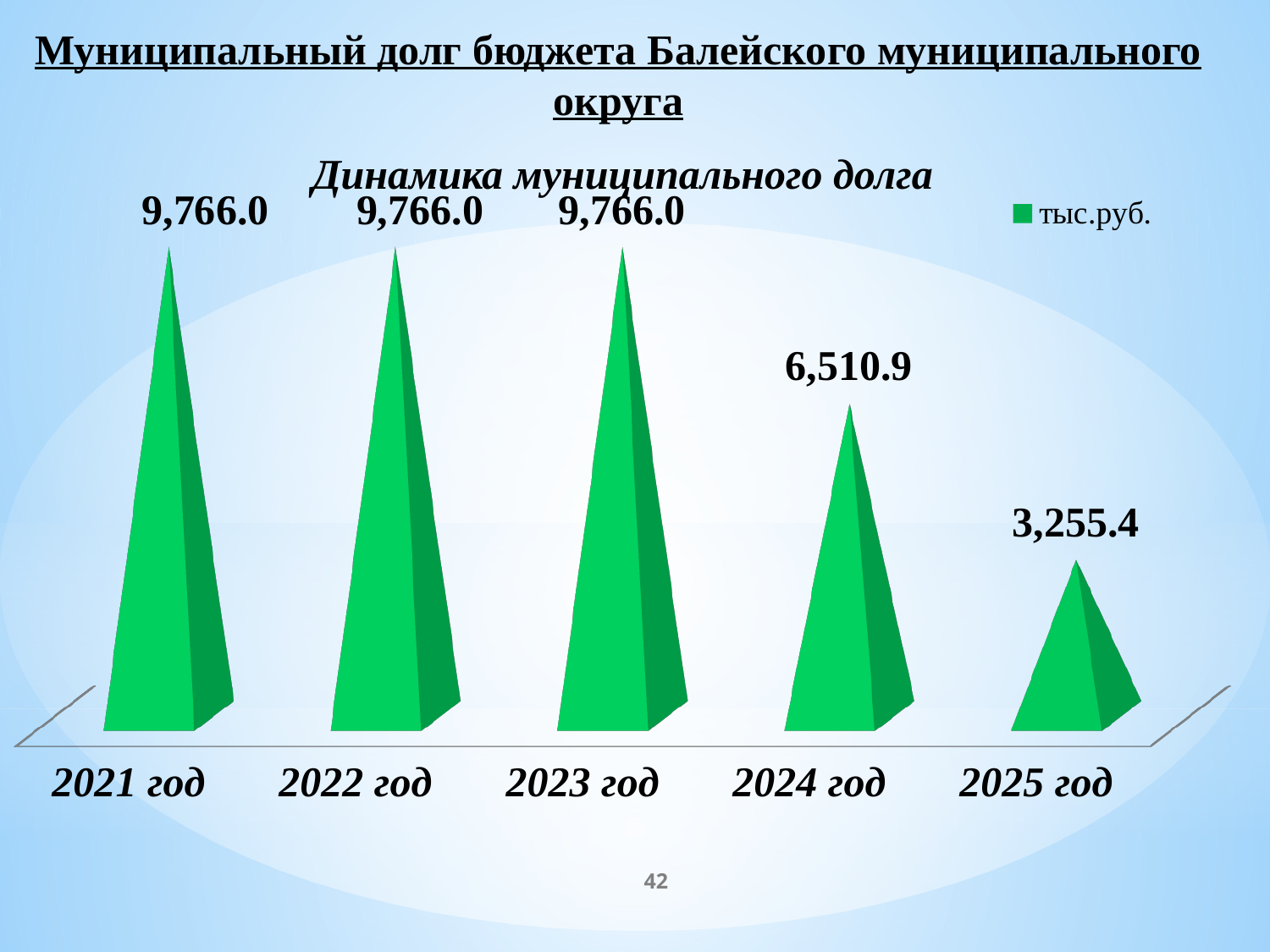
What is the value for 2023 год? 9,766.0 What is the difference between the values for 2023 год and 2024 год? 3,255.1 What is the title of the chart? Динамика муниципального долга How many years are shown on the x axis? 5 How many series does the legend list? 1 Which is larger, the value for 2022 год or the value for 2024 год? 2022 год What kind of chart is shown? bar chart What is the value for 2021 год? 9,766.0 What is the value for 2024 год? 6,510.9 What is the difference between the values for 2024 год and 2025 год? 3,255.5 What is the value for 2025 год? 3,255.4 Which year has the lowest value? 2025 год